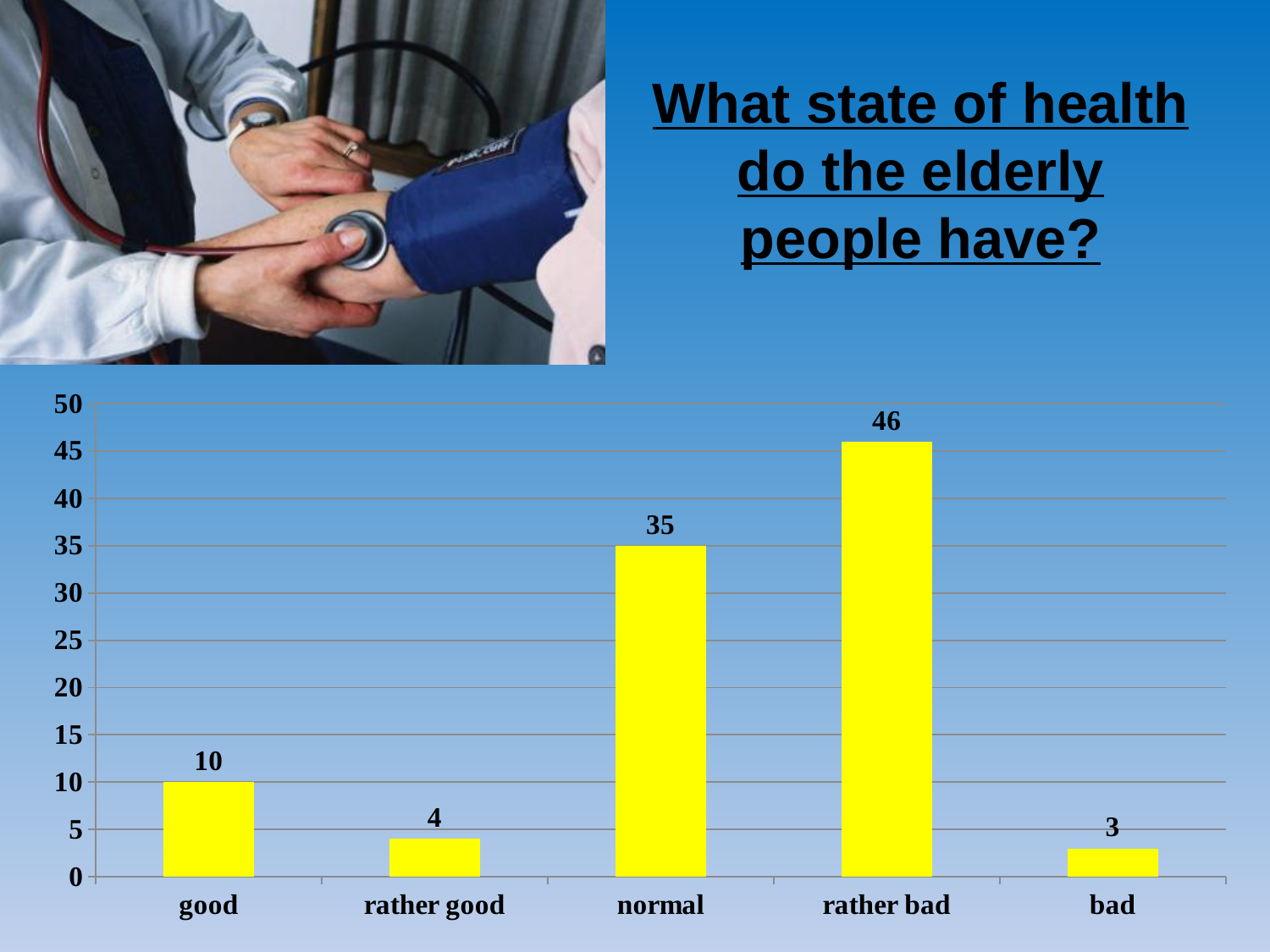
What is the value for "normal"? 35 What is the value for "good"? 10 Which category has the highest value? rather bad What kind of chart is shown on the slide? bar chart What is the value for "rather good"? 4 What is the difference between the values for "rather bad" and "normal"? 11 Which is larger, the value for "good" or the value for "rather good"? good What is the value for "rather bad"? 46 Is the value for "normal" greater or less than 30? greater What colour are the bars in the chart? yellow Which category has the lowest value? bad How many categories are shown on the x axis? 5